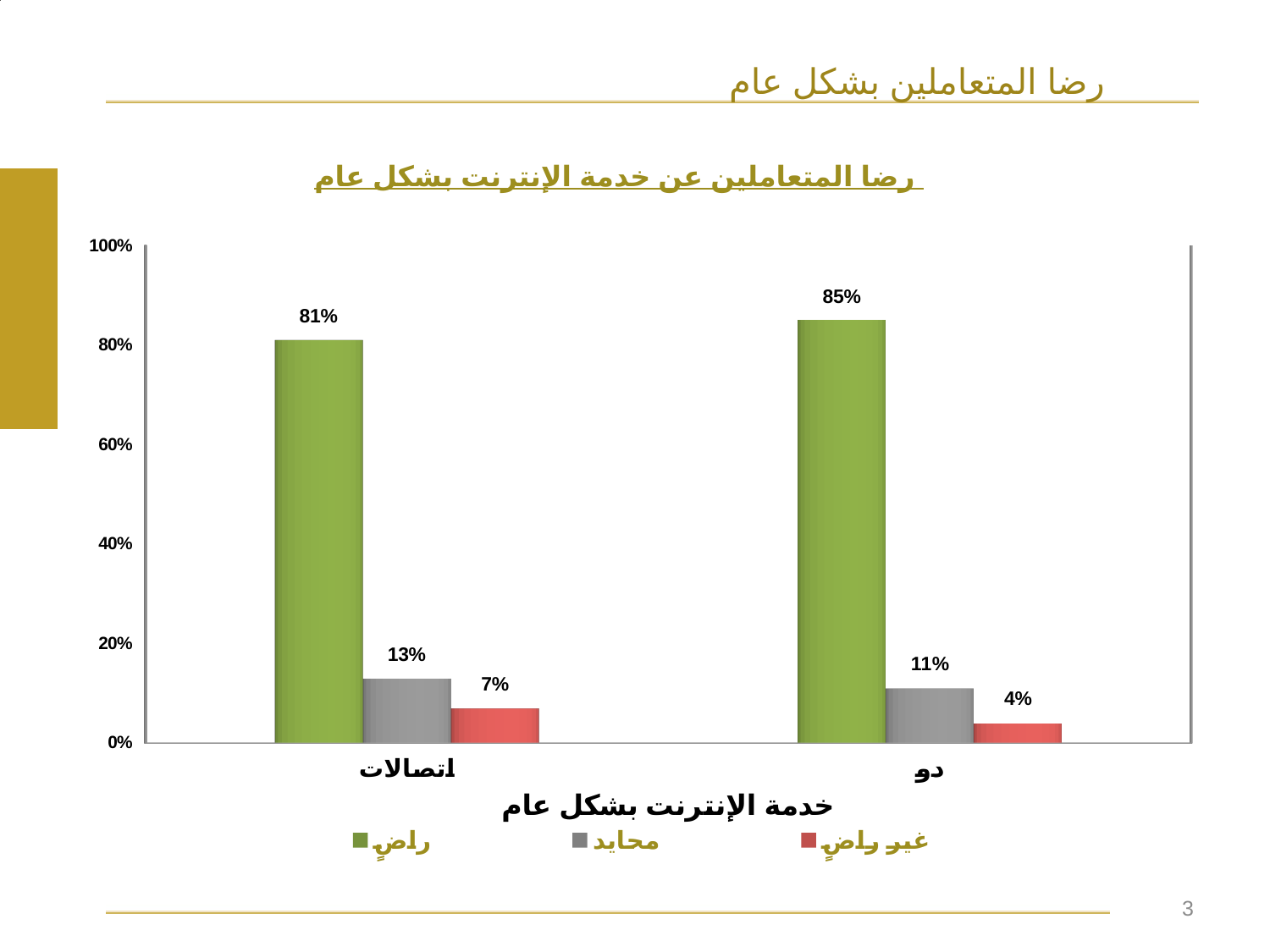
How many categories are shown on the x axis? 2 How many series does the legend list? 3 What is the value for راضٍ for اتصالات? 81% What is the difference between the راضٍ values for دو and اتصالات? 4% What is the value for راضٍ for دو? 85% Which category has the higher value for راضٍ, اتصالات or دو? دو Which series has the lowest value for دو? غير راضٍ What colour are the bars for the راضٍ series? Green What is the difference between the غير راضٍ values for اتصالات and دو? 3% What is the value for غير راضٍ for دو? 4% What kind of chart is shown on the slide? Bar chart What is the value for محايد for اتصالات? 13%